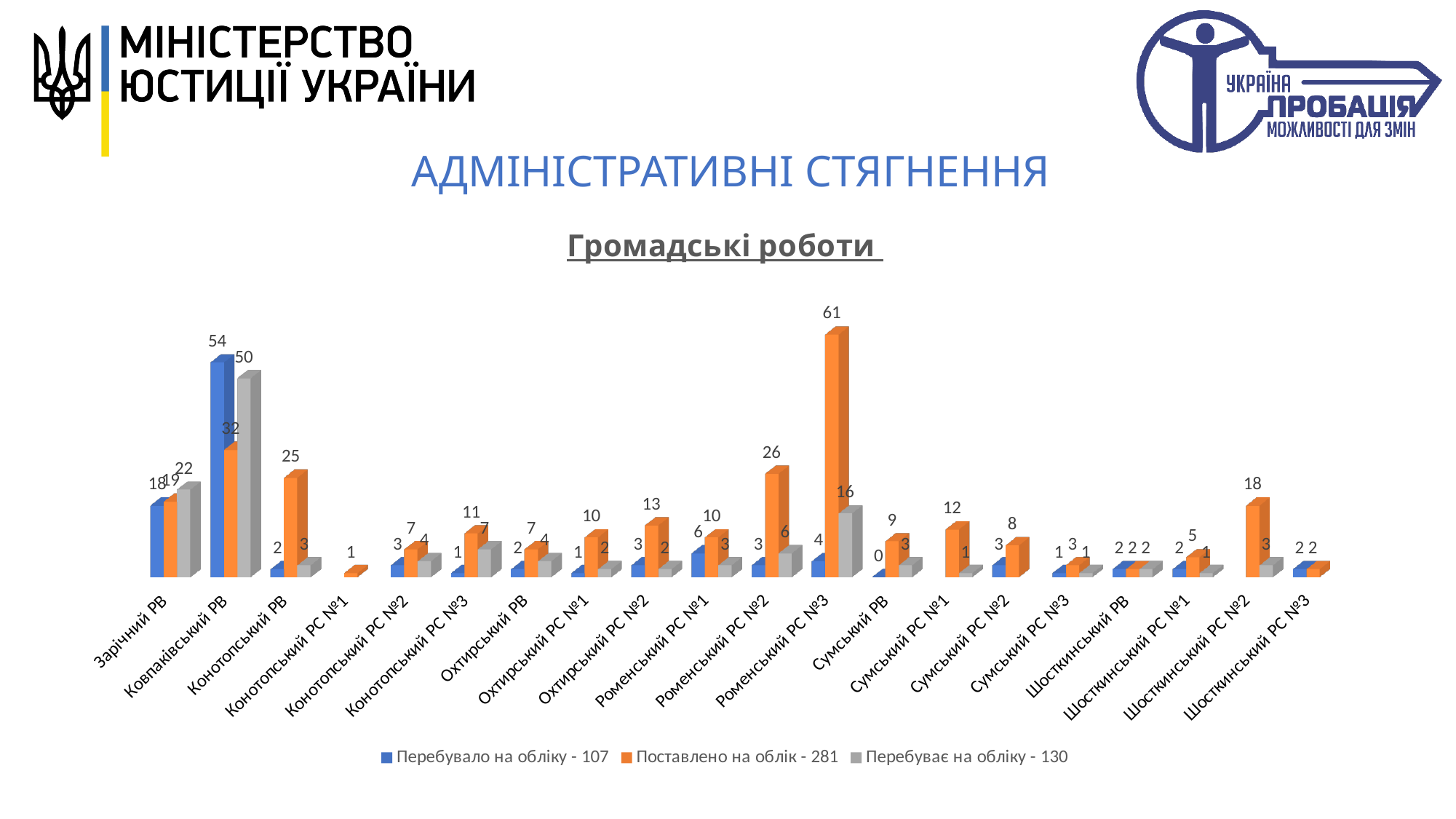
Which is larger: the "Перебувало на обліку" value for Ковпаківський РВ or its "Перебуває на обліку" value? Перебувало на обліку Which category has the highest value for "Поставлено на облік"? Роменський РС №3 Which category has the highest value for "Перебуває на обліку"? Ковпаківський РВ What is the value of "Перебуває на обліку" for Зарічний РВ? 22 What is the title of the chart? Громадські роботи How many series does the legend list? 3 What kind of chart is shown on the slide? Bar chart How many categories are shown on the x axis? 20 What is the value of "Поставлено на облік" for Роменський РС №3? 61 What is the difference between the "Поставлено на облік" values for Роменський РС №3 and Роменський РС №2? 35 What is the value of "Поставлено на облік" for Шосткинський РС №2? 18 What is the value of "Перебувало на обліку" for Ковпаківський РВ? 54